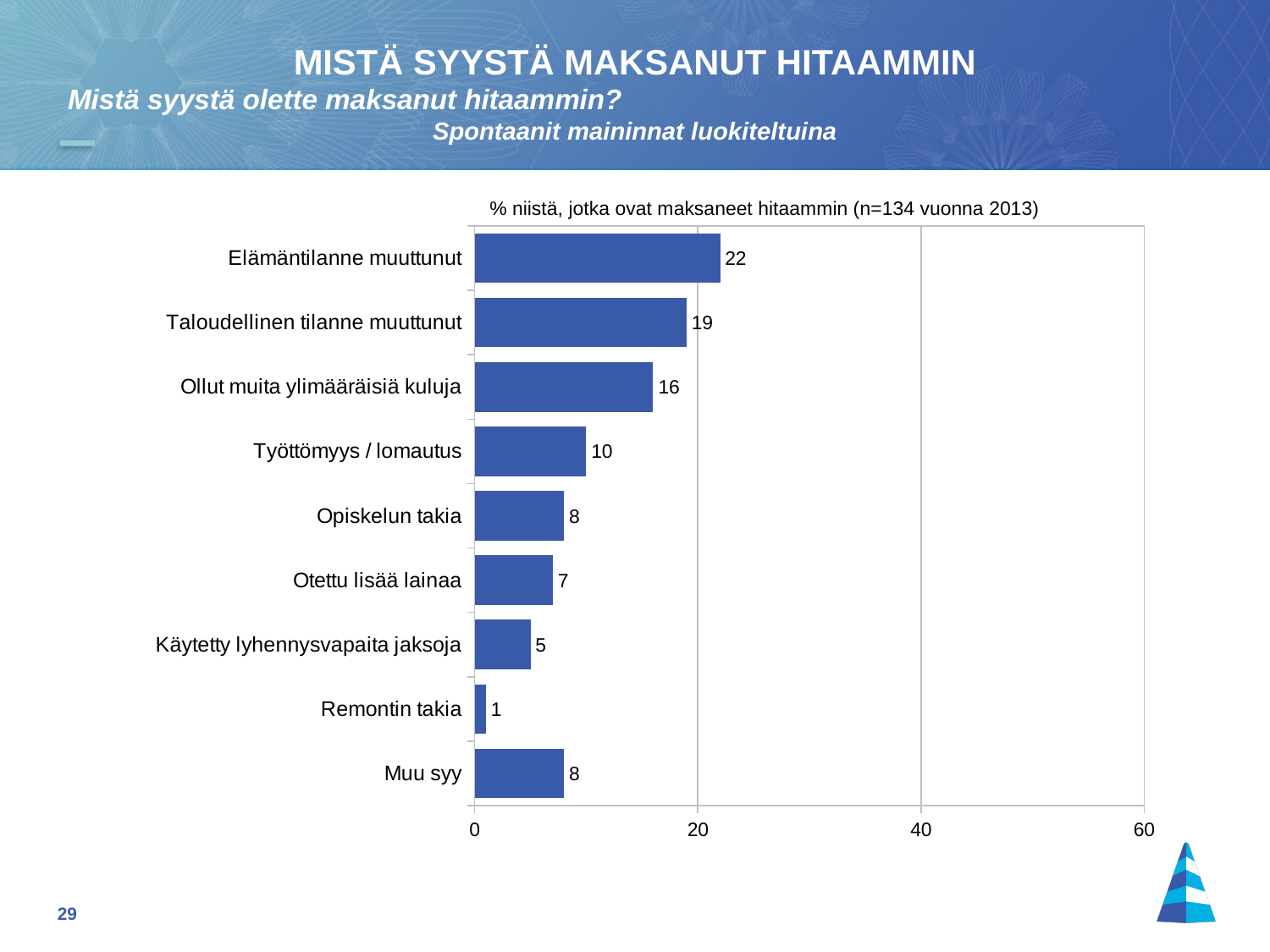
What is the value for Käytetty lyhennysvapaita jaksoja? 5 What is the value for Elämäntilanne muuttunut? 22 What is the difference between the values for Ollut muita ylimääräisiä kuluja and Otettu lisää lainaa? 9 Which is larger, the value for Opiskelun takia or the value for Otettu lisää lainaa? Opiskelun takia How many categories are shown in the chart? 9 Which category has the highest value? Elämäntilanne muuttunut What kind of chart is shown on the slide? Bar chart What is the text shown above the chart describing the base of respondents? % niistä, jotka ovat maksaneet hitaammin (n=134 vuonna 2013) Which category has the lowest value? Remontin takia Is the value for Elämäntilanne muuttunut greater or less than 20? greater What is the difference between the values for Elämäntilanne muuttunut and Taloudellinen tilanne muuttunut? 3 What is the value for Työttömyys / lomautus? 10